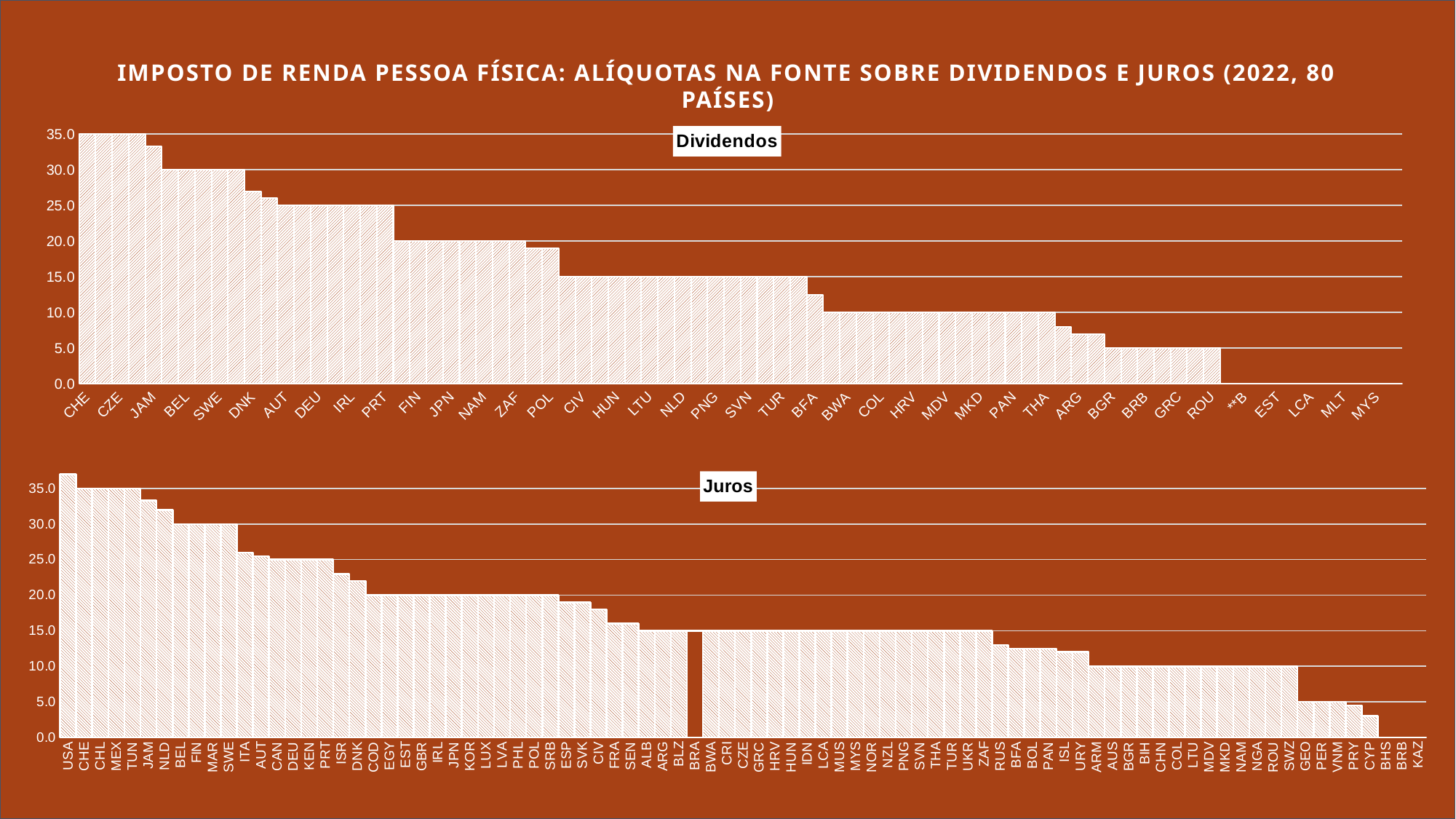
In the Juros chart, is the value for ISR greater or less than 20.0? greater In the Juros chart, which is larger, the value for DEU or the value for COD? DEU What kind of chart is the Dividendos chart? bar chart In the Dividendos chart, what is the difference between the values for CHE and ROU? 30.0 In the Dividendos chart, is the value for JAM greater or less than 30.0? greater In the Juros chart, which country has the highest value? USA In the Dividendos chart, what is the value for FIN? 20.0 In the Juros chart, what is the value for MAR? 30.0 In the Juros chart, do the values rise or fall from left to right along the x axis? fall In the Dividendos chart, is the value for ARG greater or less than 10.0? less In the Dividendos chart, what is the value for ROU? 5.0 In the Dividendos chart, what is the value for BEL? 30.0